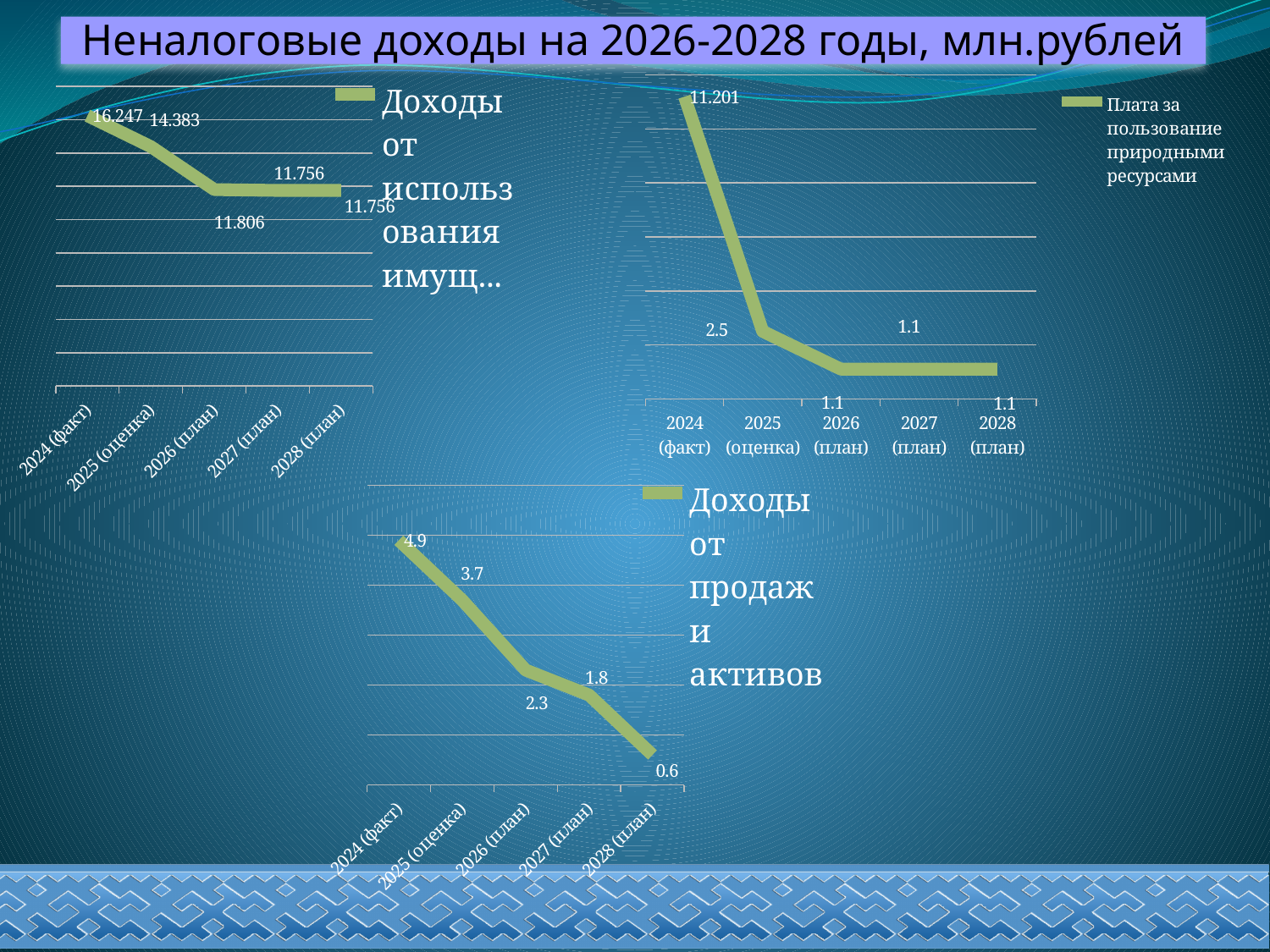
In the top-right chart (Плата за пользование природными ресурсами), what is the difference between the 2024 (факт) and 2025 (оценка) values? 8.701 In the top-left chart (Доходы от использования имущ...), what is the value for 2026 (план)? 11.806 In the bottom chart (Доходы от продаж и активов), what is the value for 2028 (план)? 0.6 In the top-left chart (Доходы от использования имущ...), what is the difference between the 2024 (факт) and 2025 (оценка) values? 1.864 In the top-right chart (Плата за пользование природными ресурсами), what is the value for 2025 (оценка)? 2.5 In the bottom chart (Доходы от продаж и активов), which category has the lowest value? 2028 (план) In the top-right chart (Плата за пользование природными ресурсами), what is the value for 2024 (факт)? 11.201 How many categories are shown on the x axis of the bottom chart (Доходы от продаж и активов)? 5 In the top-right chart (Плата за пользование природными ресурсами), which category has the highest value? 2024 (факт) In the top-left chart (Доходы от использования имущ...), do the values rise or fall from 2024 (факт) to 2028 (план)? fall In the top-left chart (Доходы от использования имущ...), what is the value for 2024 (факт)? 16.247 In the bottom chart (Доходы от продаж и активов), which is larger: the value for 2025 (оценка) or the value for 2027 (план)? 2025 (оценка)